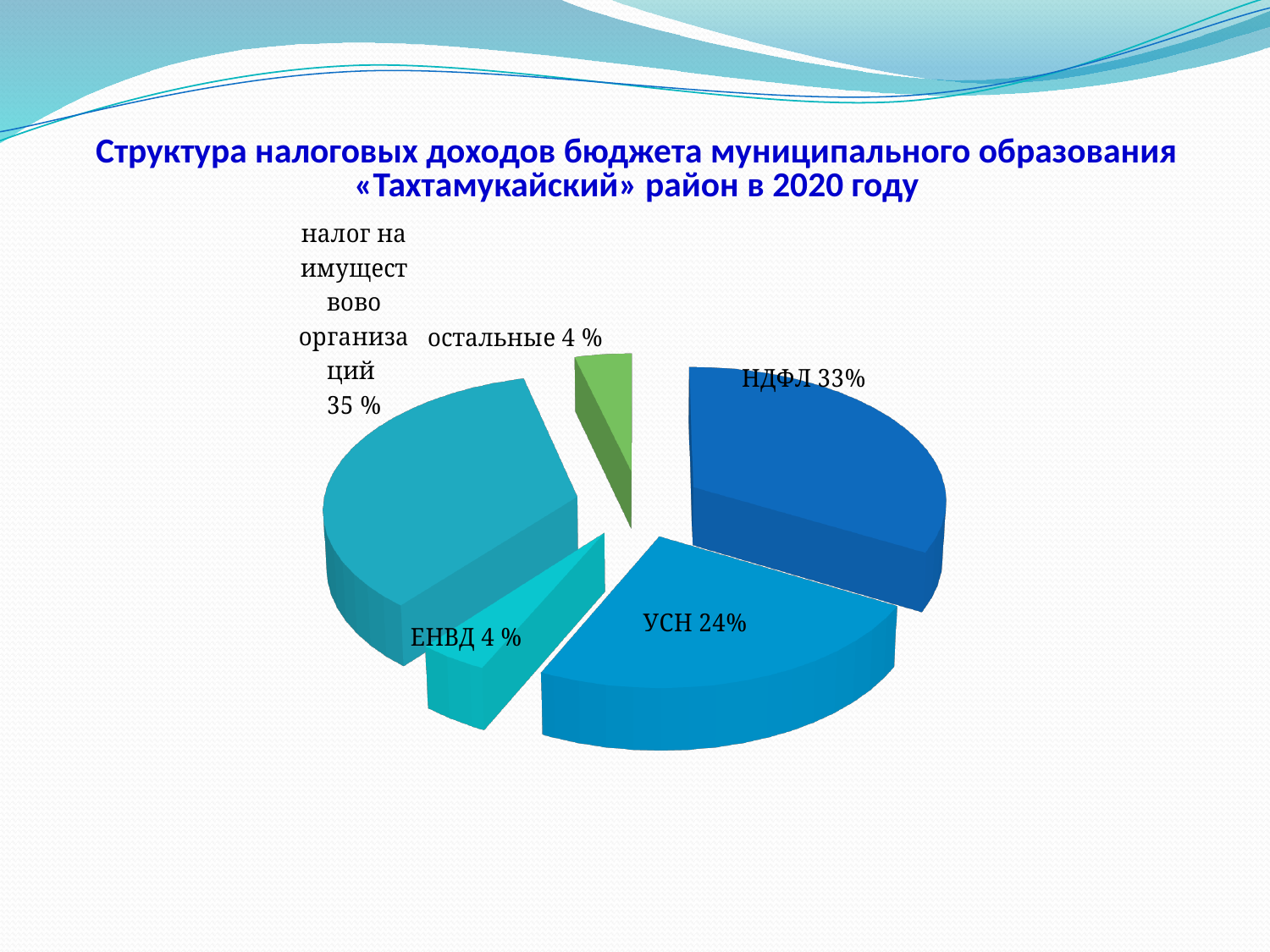
What colour is the slice for остальные? green What percentage is shown for УСН? 24% Which is larger, the share for НДФЛ or the share for УСН? НДФЛ How many slices does the pie chart have? 5 By how many percentage points does the share for НДФЛ exceed the share for УСН? 9% What kind of chart is shown on the slide? pie chart What share of the pie does НДФЛ account for? 33% What percentage is shown for налог на имущество организаций? 35 % By how many percentage points does налог на имущество организаций exceed НДФЛ? 2% What percentage is shown for остальные? 4 % Which category has the largest share of the pie? налог на имущество организаций What percentage is shown for ЕНВД? 4 %